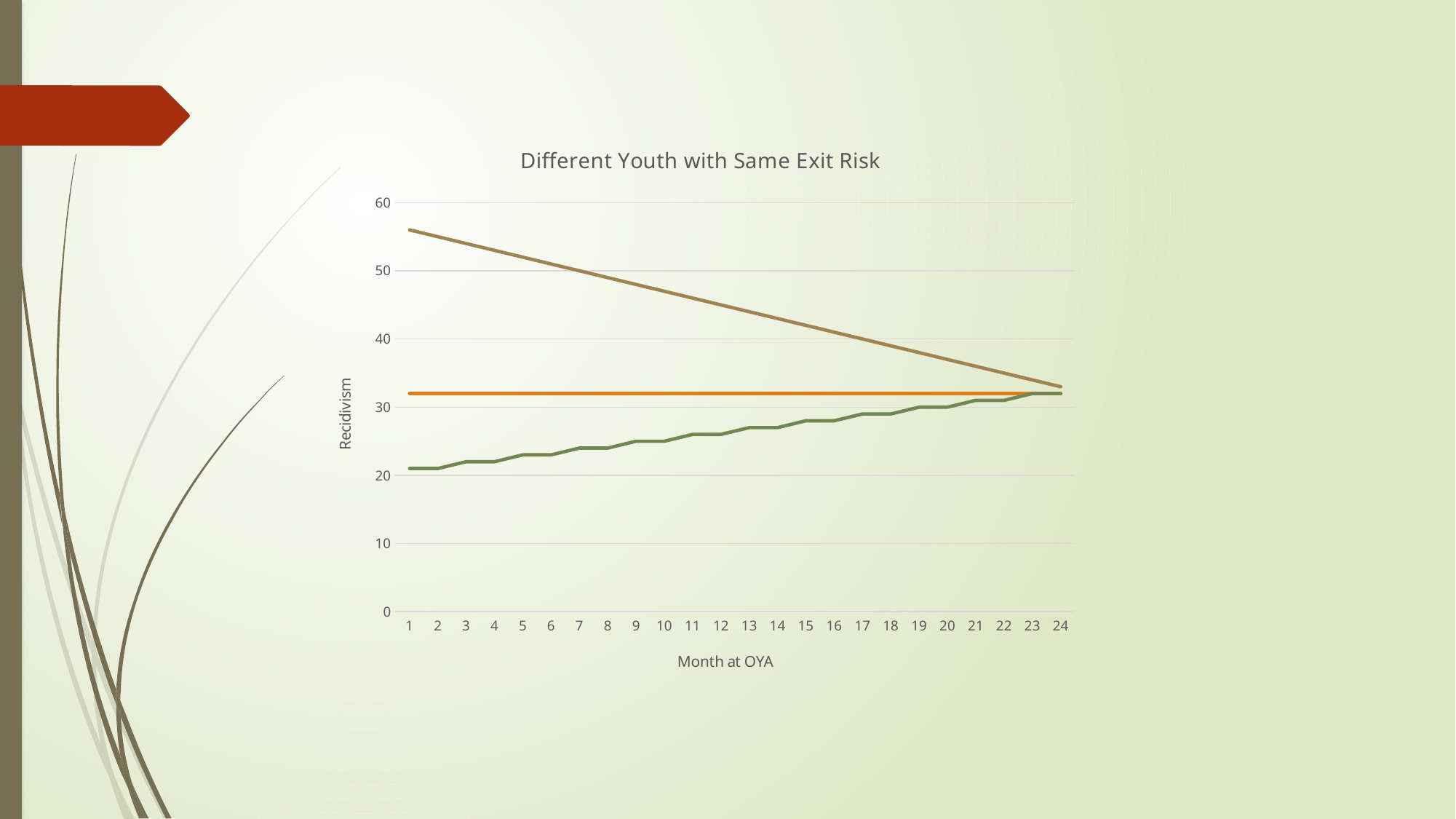
What is the title of the chart? Different Youth with Same Exit Risk Is the value of the brown line at month 12 greater or less than 40? greater Does the green line rise or fall from month 1 to month 24? rises How many months are shown along the x axis? 24 How many lines are plotted on the chart? 3 What kind of chart is shown on the slide? line chart Is the value of the orange line greater or less than 30? greater Is the value of the brown line at month 1 greater or less than 50? greater Does the brown line rise or fall from month 1 to month 24? falls At month 1, which line has the higher recidivism value, the brown line or the green line? brown line What is the label of the x axis? Month at OYA